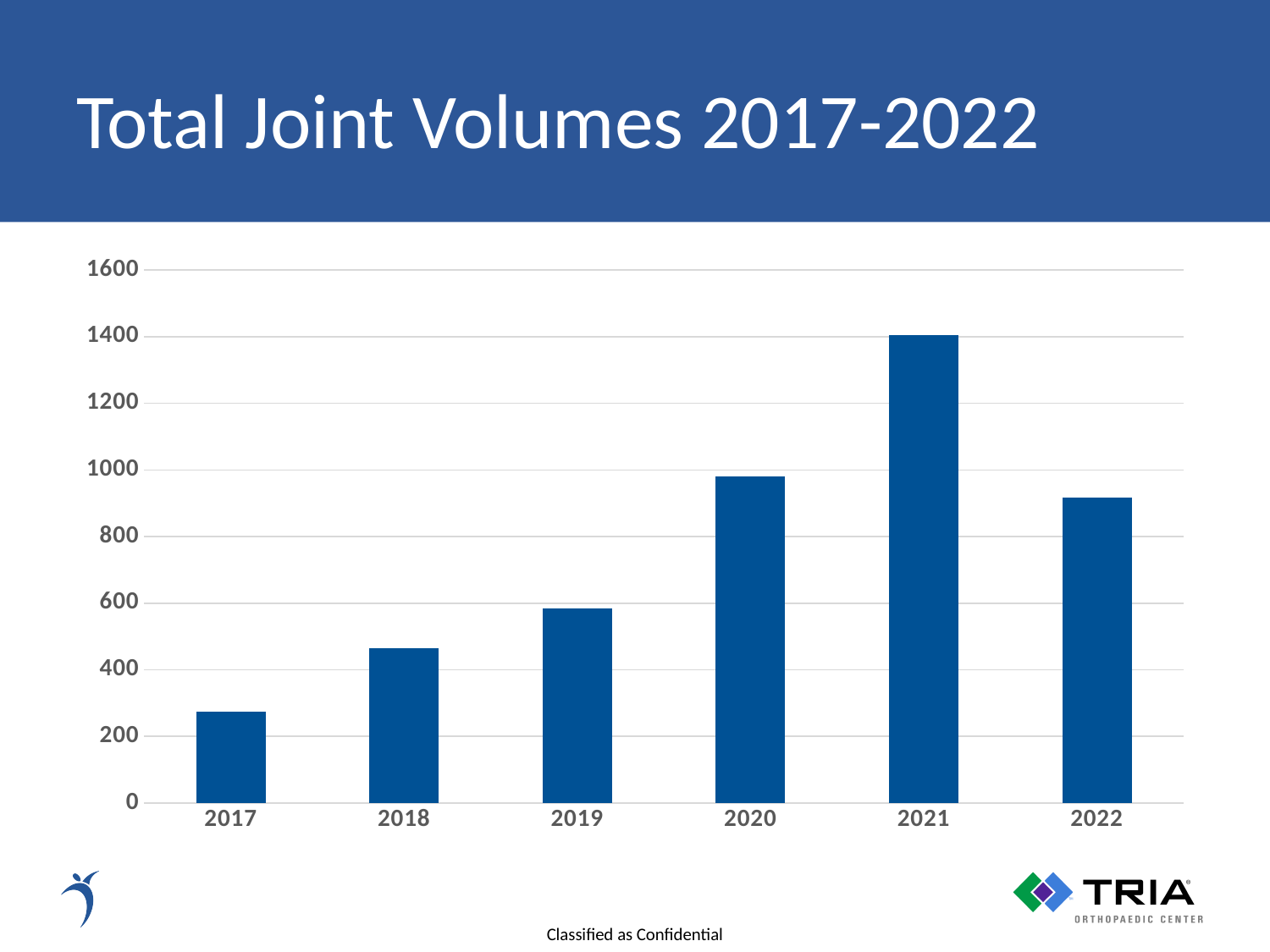
Do the values rise or fall from 2021 to 2022? fall Do the values rise or fall from 2017 to 2021? rise Which year has the lowest total joint volume? 2017 Is the value for 2022 greater or less than 1000? less Is the value for 2017 greater or less than 200? greater What kind of chart is shown on the slide? bar chart How many years are shown on the x axis of the chart? 6 Is the value for 2021 greater or less than 1200? greater What is the title of the chart on the slide? Total Joint Volumes 2017-2022 Which year has the highest total joint volume? 2021 Which year has the larger total joint volume, 2020 or 2022? 2020